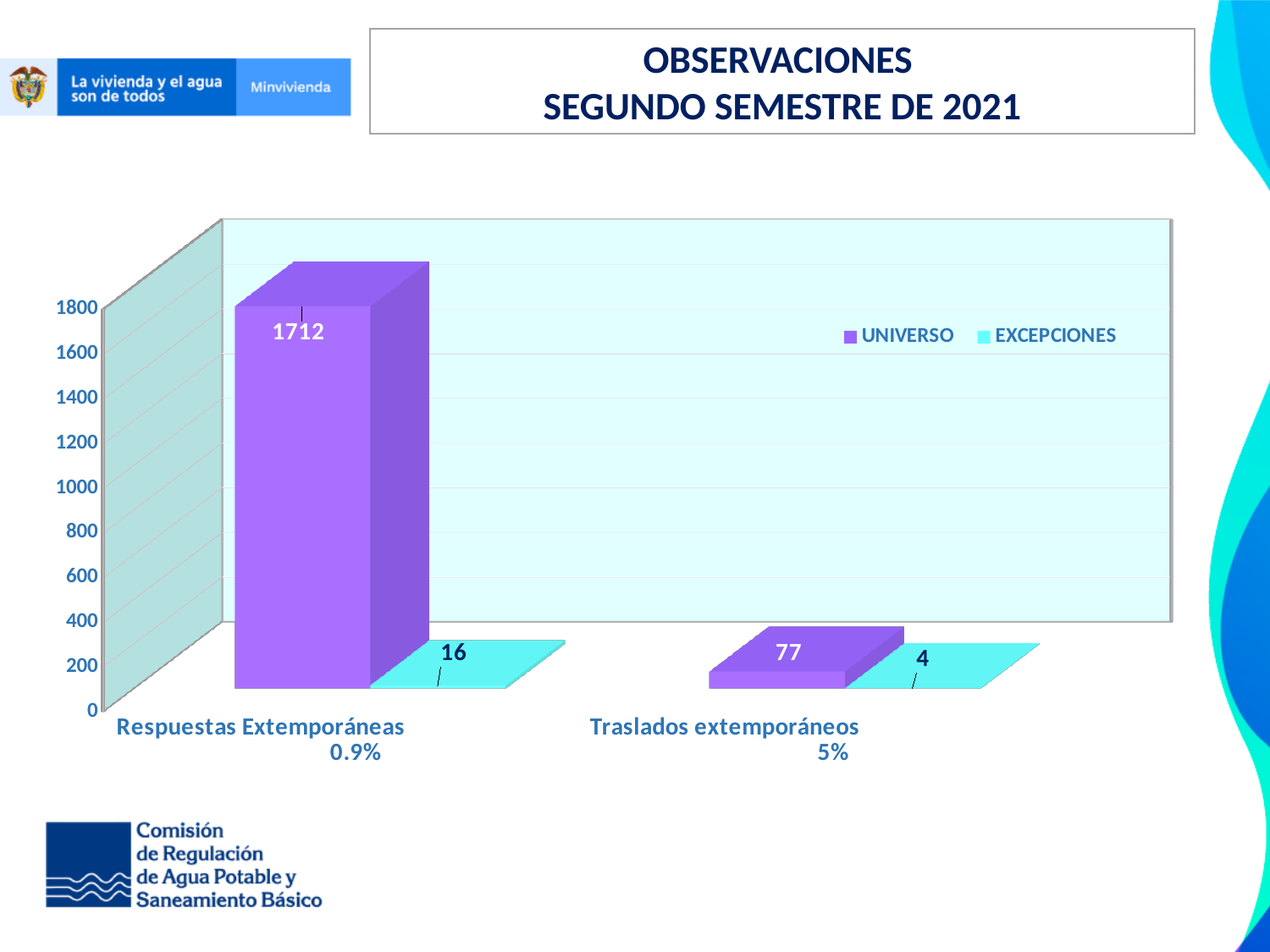
What is the EXCEPCIONES value for Respuestas Extemporáneas? 16 What is the UNIVERSO value for Traslados extemporáneos? 77 Which category has the highest UNIVERSO value? Respuestas Extemporáneas How many series does the legend list? 2 What is the difference between the UNIVERSO values for Respuestas Extemporáneas and Traslados extemporáneos? 1635 Which category has the lowest EXCEPCIONES value? Traslados extemporáneos Which is larger: the EXCEPCIONES value for Respuestas Extemporáneas or the UNIVERSO value for Traslados extemporáneos? UNIVERSO value for Traslados extemporáneos How many categories are shown on the x axis? 2 What is the EXCEPCIONES value for Traslados extemporáneos? 4 What is the difference between the UNIVERSO and EXCEPCIONES values for Traslados extemporáneos? 73 What kind of chart is shown on the slide? Bar chart What is the UNIVERSO value for Respuestas Extemporáneas? 1712